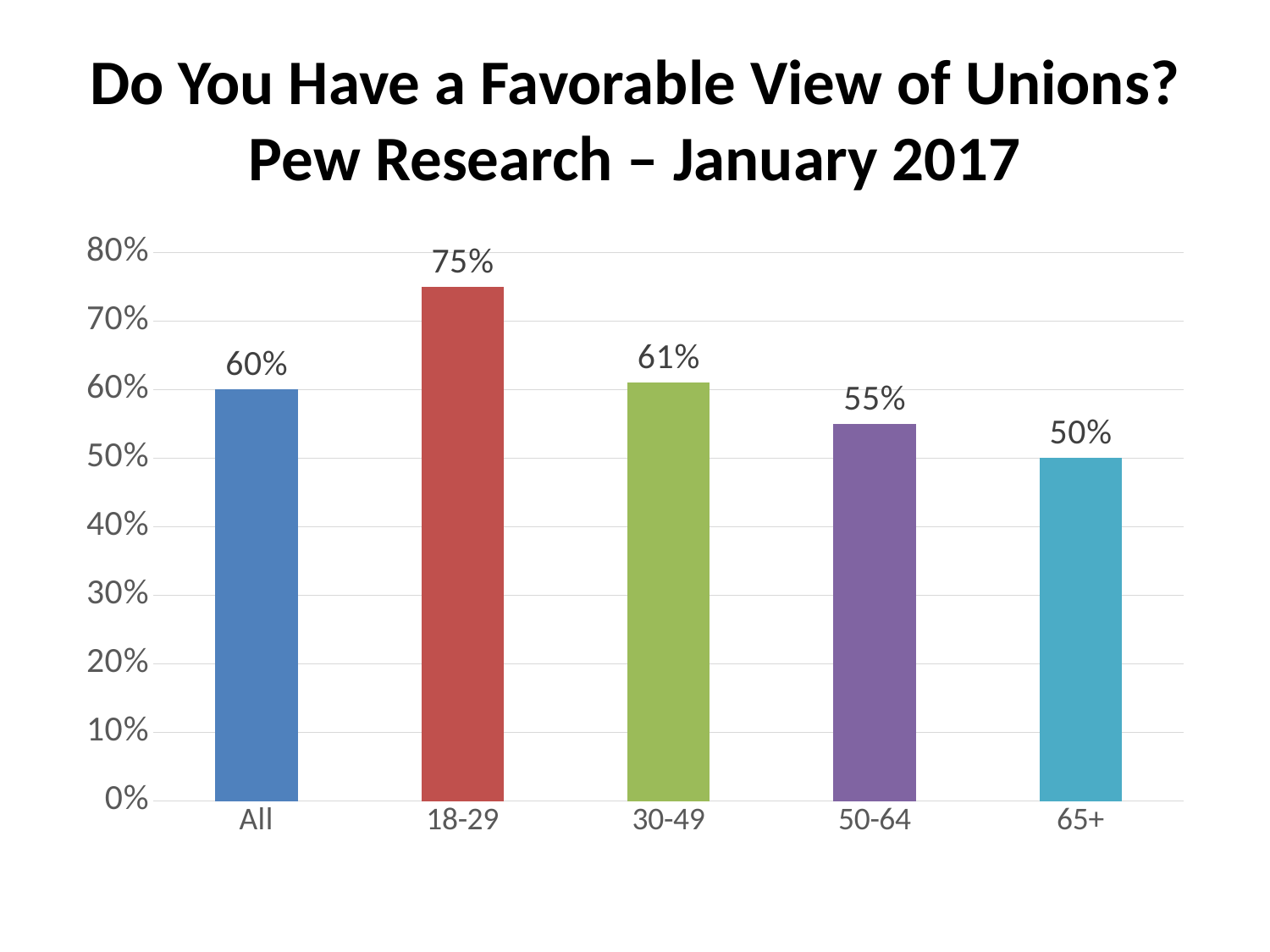
What is the difference between the values for 18-29 and 65+? 25% How many categories are shown on the x axis? 5 What kind of chart is shown on the slide? bar chart What is the value for the 65+ age group? 50% What is the value for the All category? 60% Is the value for 50-64 greater or less than 60%? less What is the value for the 18-29 age group? 75% Which age group has the lowest favorable view of unions? 65+ Do the values rise or fall across the age groups from 18-29 to 65+? fall Which is larger, the value for 30-49 or the value for 50-64? 30-49 What is the difference between the values for 30-49 and 50-64? 6% Which age group has the highest favorable view of unions? 18-29